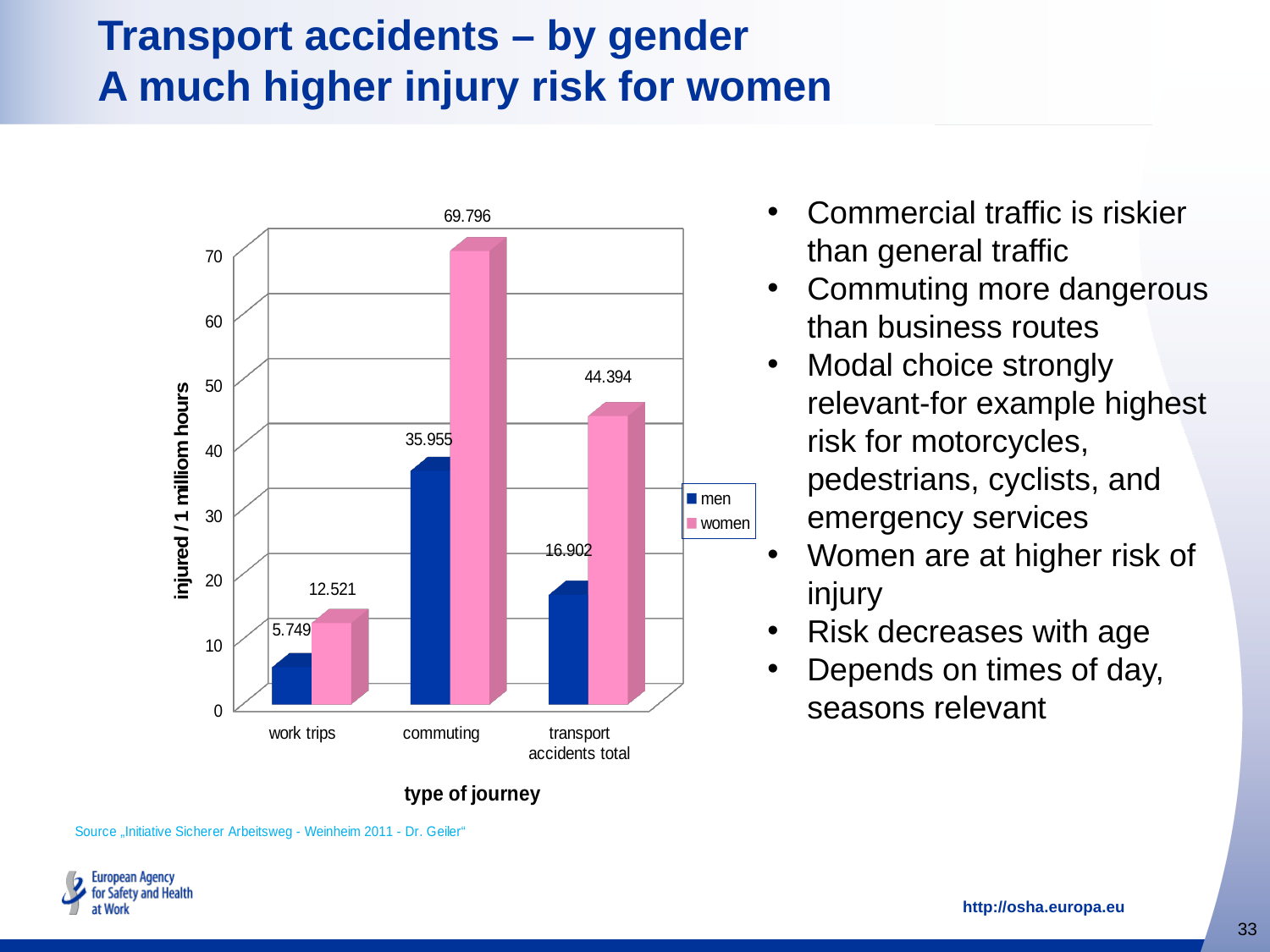
How many series does the legend list? 2 What is the value for women for commuting? 69.796 What kind of chart is shown on the slide? bar chart How many types of journey are shown on the x axis? 3 What is the difference between the women and men values for transport accidents total? 27.492 What is the value for women for work trips? 12.521 Which is larger for work trips, the value for men or for women? women What is the difference between the women and men values for commuting? 33.841 Which type of journey has the lowest value for men? work trips What is the value for men for work trips? 5.749 What is the value for men for transport accidents total? 16.902 Which type of journey has the highest value for women? commuting